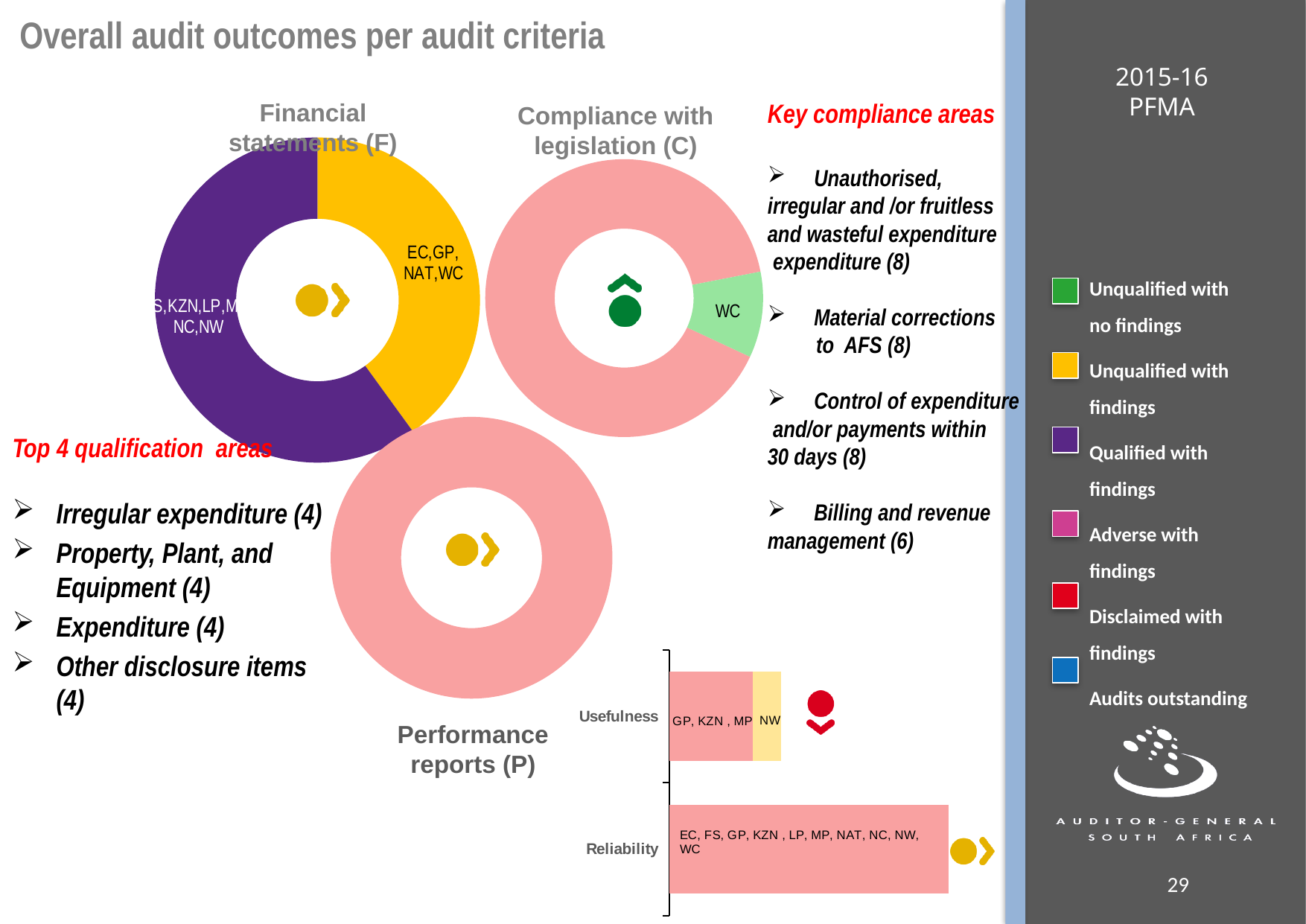
How many segments does the 'Financial statements (F)' donut chart have? 2 How many segments does the 'Compliance with legislation (C)' donut chart have? 2 In the 'Compliance with legislation (C)' chart, which segment is the smallest? The green segment (WC) What kind of chart is the chart at the bottom right with the 'Usefulness' and 'Reliability' categories? Bar chart In the 'Financial statements (F)' chart, which provinces are listed in the yellow segment? EC, GP, NAT, WC In the 'Compliance with legislation (C)' chart, what label is shown on the small green segment? WC What kind of chart is the 'Financial statements (F)' chart? Donut (pie) chart In the 'Financial statements (F)' chart, which segment is larger, the yellow one or the purple one? Purple In the bottom-right bar chart, what label is shown on the yellow segment of the 'Usefulness' bar? NW How many segments does the 'Performance reports (P)' donut chart have? 1 In the bottom-right bar chart, which bar is longer, 'Usefulness' or 'Reliability'? Reliability How many entries does the legend on the right side of the slide list? 6